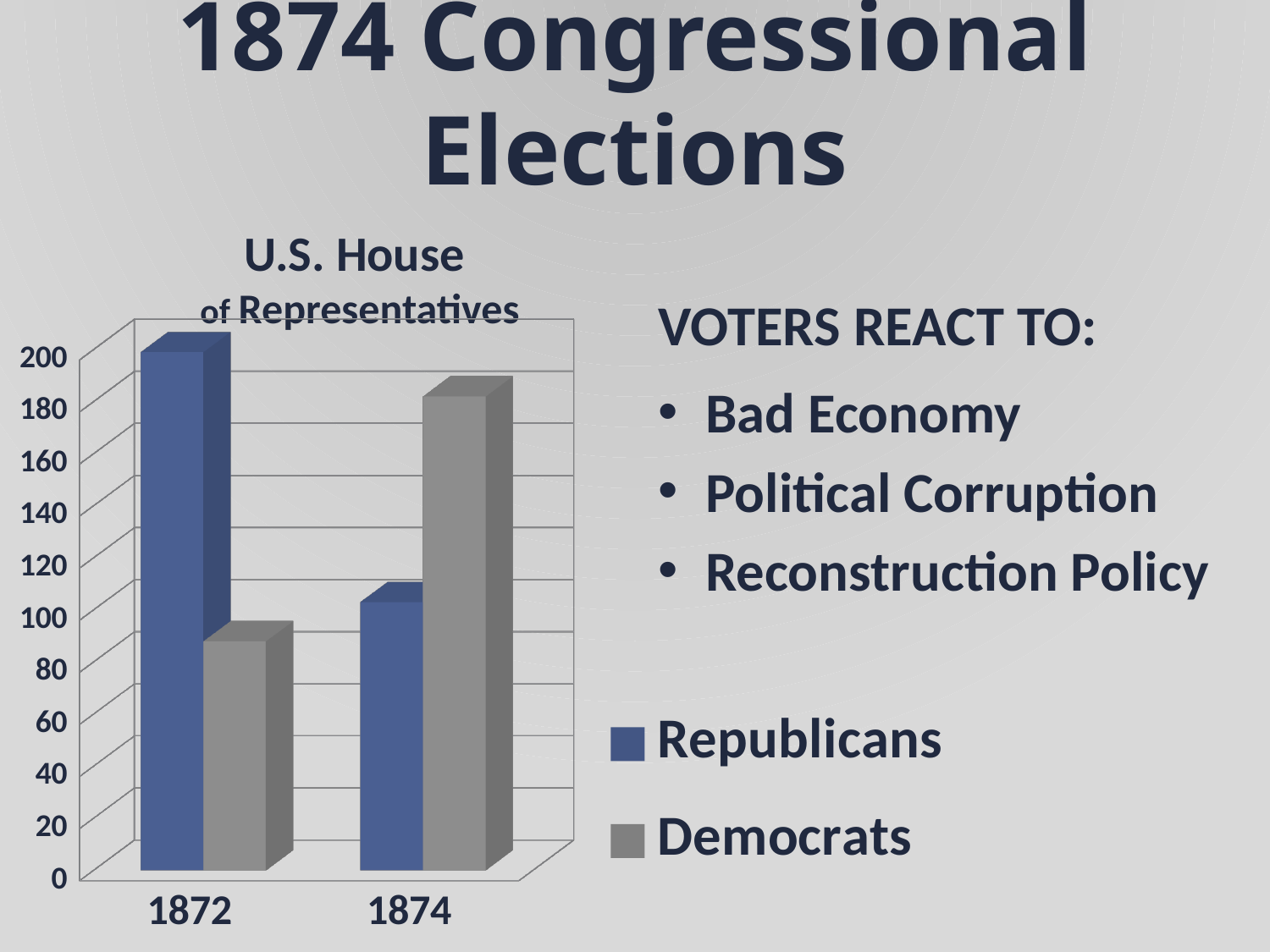
Is the value for Republicans in 1872 greater or less than 180? greater Do the Republicans' values rise or fall from 1872 to 1874? fall What is the title of the chart? U.S. House of Representatives What kind of chart is shown on the slide? bar chart How many election years are shown on the x axis of the chart? 2 Which party had more seats in 1874, Republicans or Democrats? Democrats Is the value for Democrats in 1874 greater or less than 160? greater Is the value for Republicans in 1874 greater or less than 140? less Which party had more seats in 1872, Republicans or Democrats? Republicans How many series does the chart legend list? 2 Which series is shown in blue in the chart? Republicans